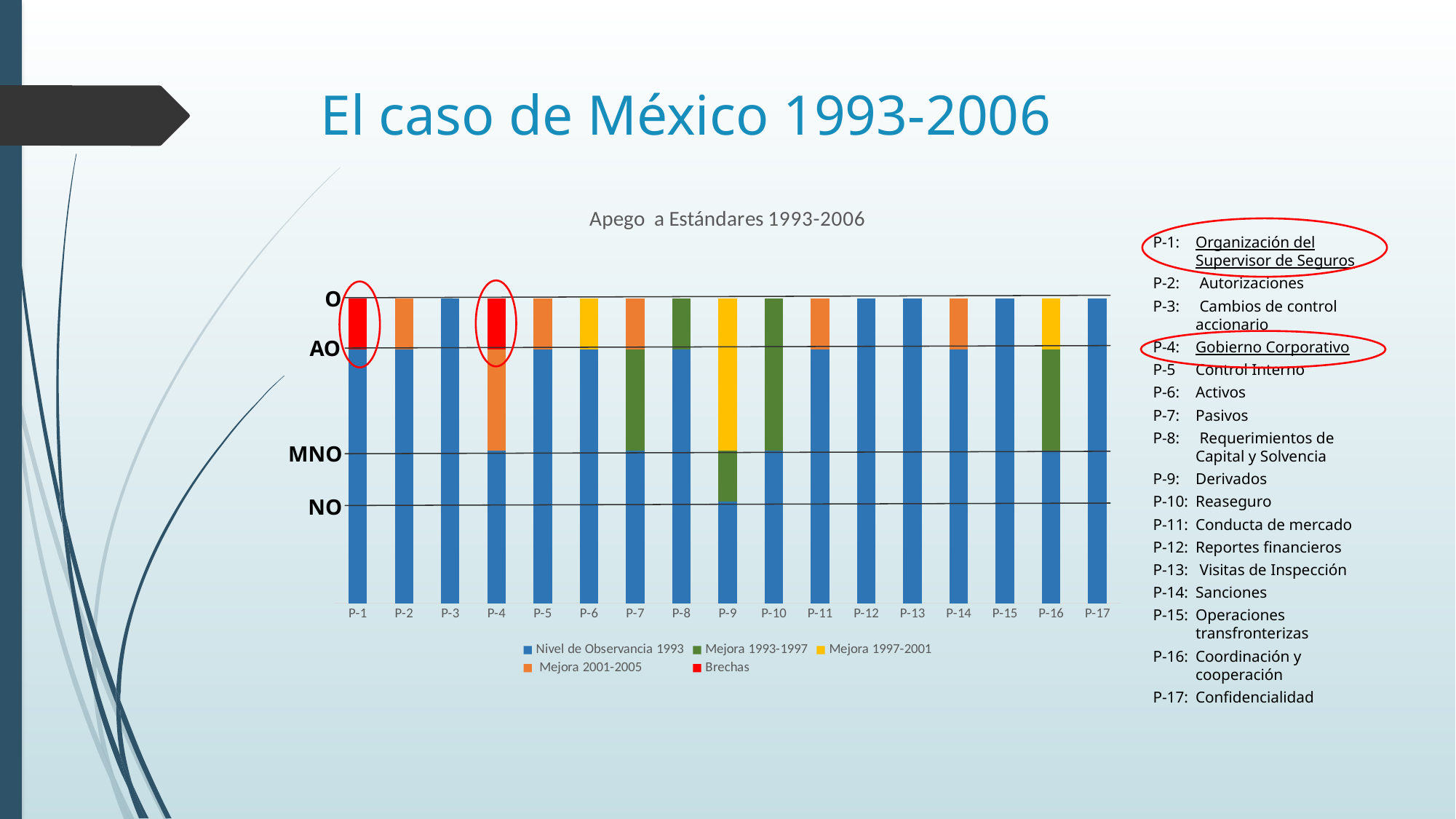
Which category's bar is made up of blue, green and yellow segments? P-9 and P-16 What level on the y axis does the blue 'Nivel de Observancia 1993' bar for P-4 reach? MNO What is the title of the chart? Apego a Estándares 1993-2006 What level on the y axis does the blue 'Nivel de Observancia 1993' bar for P-9 reach? NO Which category has the lowest 'Nivel de Observancia 1993' (blue bar)? P-9 How many categories (P-1 to P-17) are plotted on the x axis of the chart? 17 Which two categories have a red 'Brechas' segment at the top of their bar? P-1 and P-4 Is the 'Nivel de Observancia 1993' bar for P-3 higher or lower than the one for P-7? Higher What kind of chart is shown on the slide? Stacked bar chart What is the highest level labelled on the y axis of the chart? O How many series does the chart legend list? 5 Which series in the legend is shown in red? Brechas